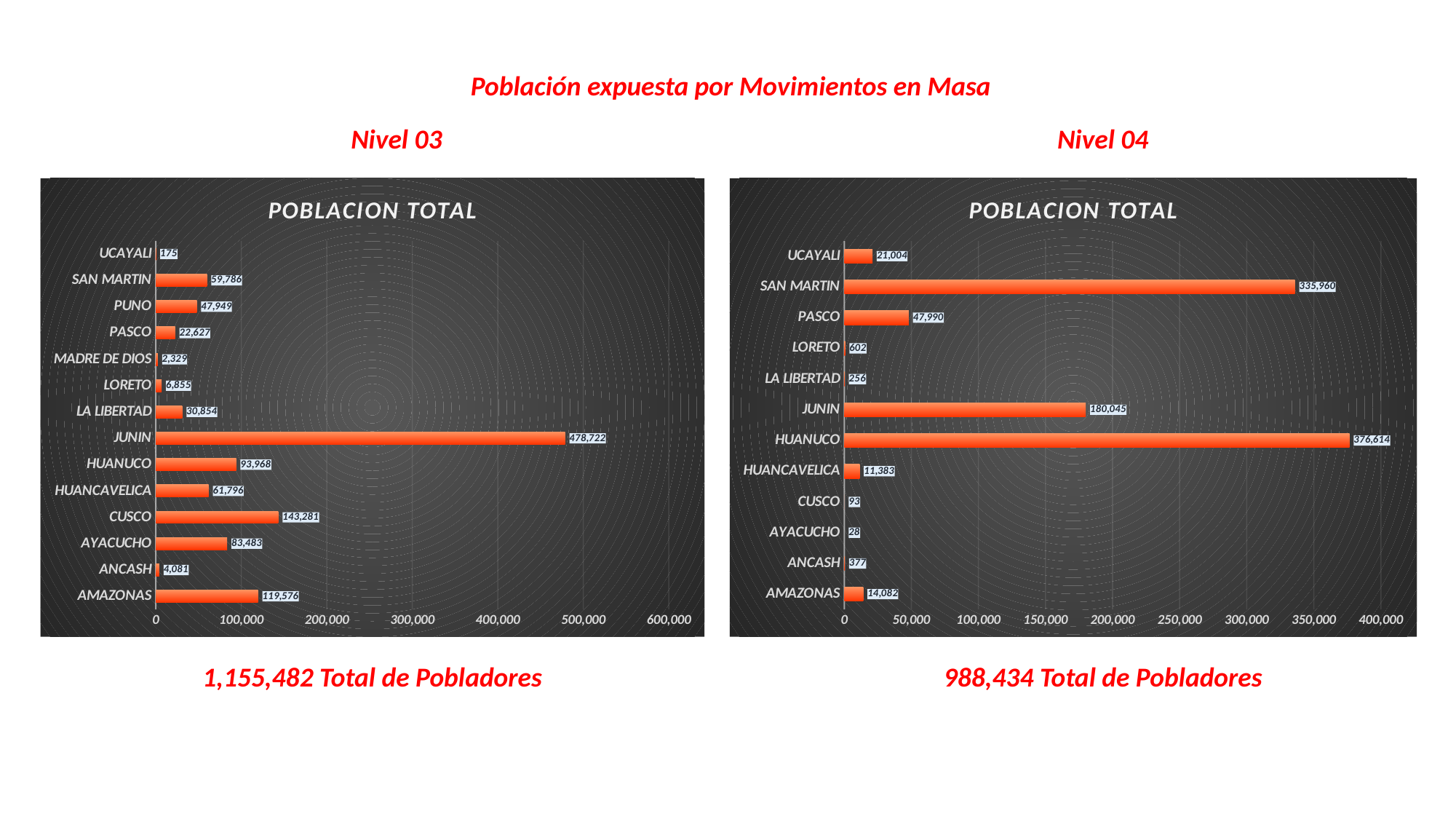
In the Nivel 03 chart, what is the difference between CUSCO and AMAZONAS? 23,705 What is the title shown inside the Nivel 04 chart? POBLACION TOTAL In the Nivel 04 chart, how many regions are shown? 12 In the Nivel 03 chart, which region has the highest population? JUNIN What type of chart is the Nivel 03 chart? Bar chart In the Nivel 04 chart, what is the value for SAN MARTIN? 335,960 In the Nivel 03 chart, how many regions are shown? 14 In the Nivel 04 chart, which is larger, JUNIN or PASCO? JUNIN In the Nivel 04 chart, which region has the highest population? HUANUCO In the Nivel 03 chart, what is the value for JUNIN? 478,722 In the Nivel 04 chart, which region has the lowest population? AYACUCHO In the Nivel 03 chart, which region has the lowest population? UCAYALI